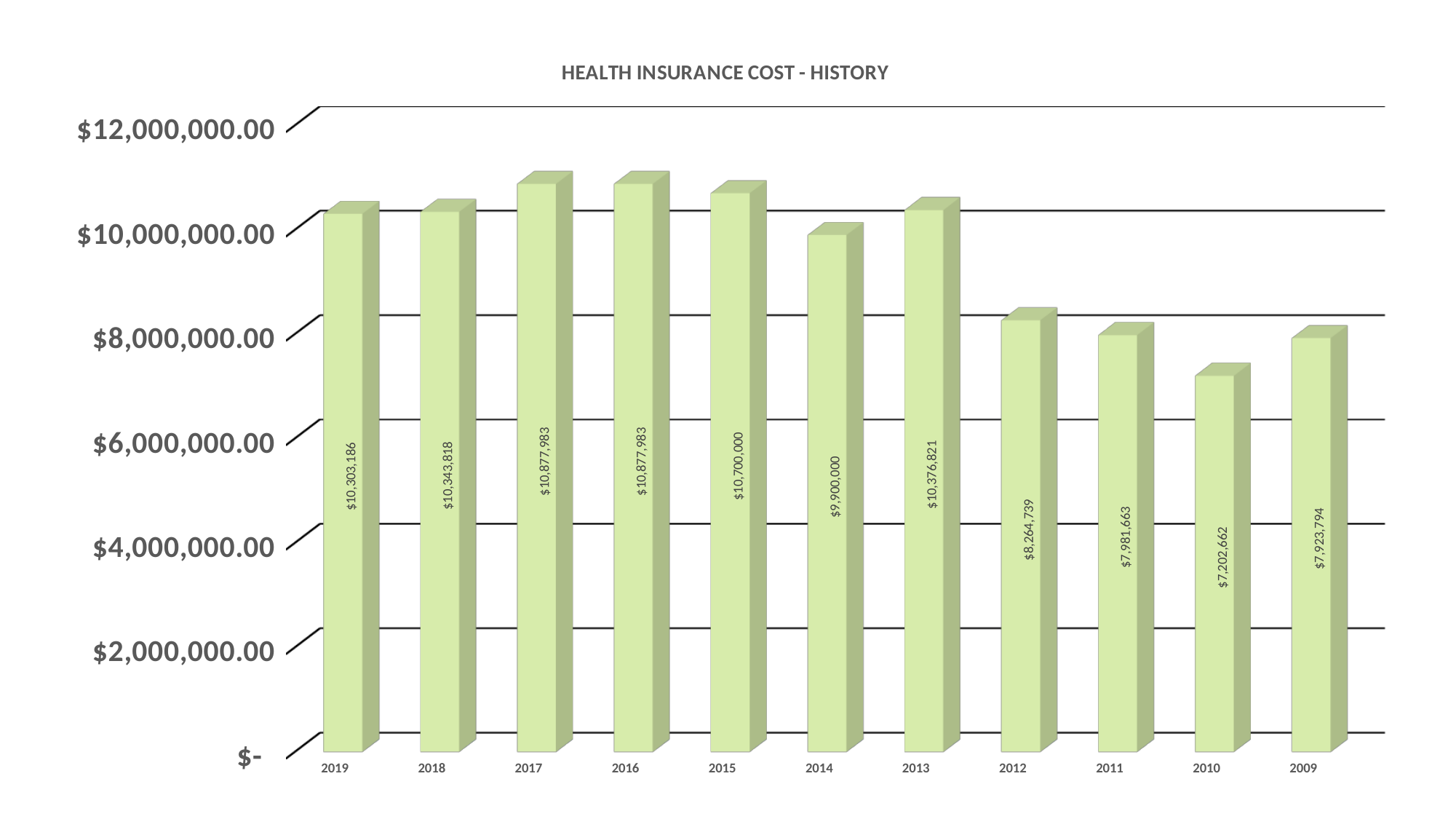
Is the health insurance cost for 2014 greater or less than $10,000,000.00? less Which year has the lowest health insurance cost? 2010 What is the health insurance cost shown for 2014? $9,900,000 What is the highest health insurance cost value shown on the chart? $10,877,983 What is the health insurance cost shown for 2019? $10,303,186 What kind of chart is shown on the slide? bar chart What is the difference between the health insurance cost in 2018 and in 2019? $40,632 What is the difference between the health insurance cost in 2015 and in 2014? $800,000 Which year has the larger health insurance cost, 2012 or 2011? 2012 What is the title of the chart? HEALTH INSURANCE COST - HISTORY How many years are shown on the chart? 11 What is the health insurance cost shown for 2010? $7,202,662